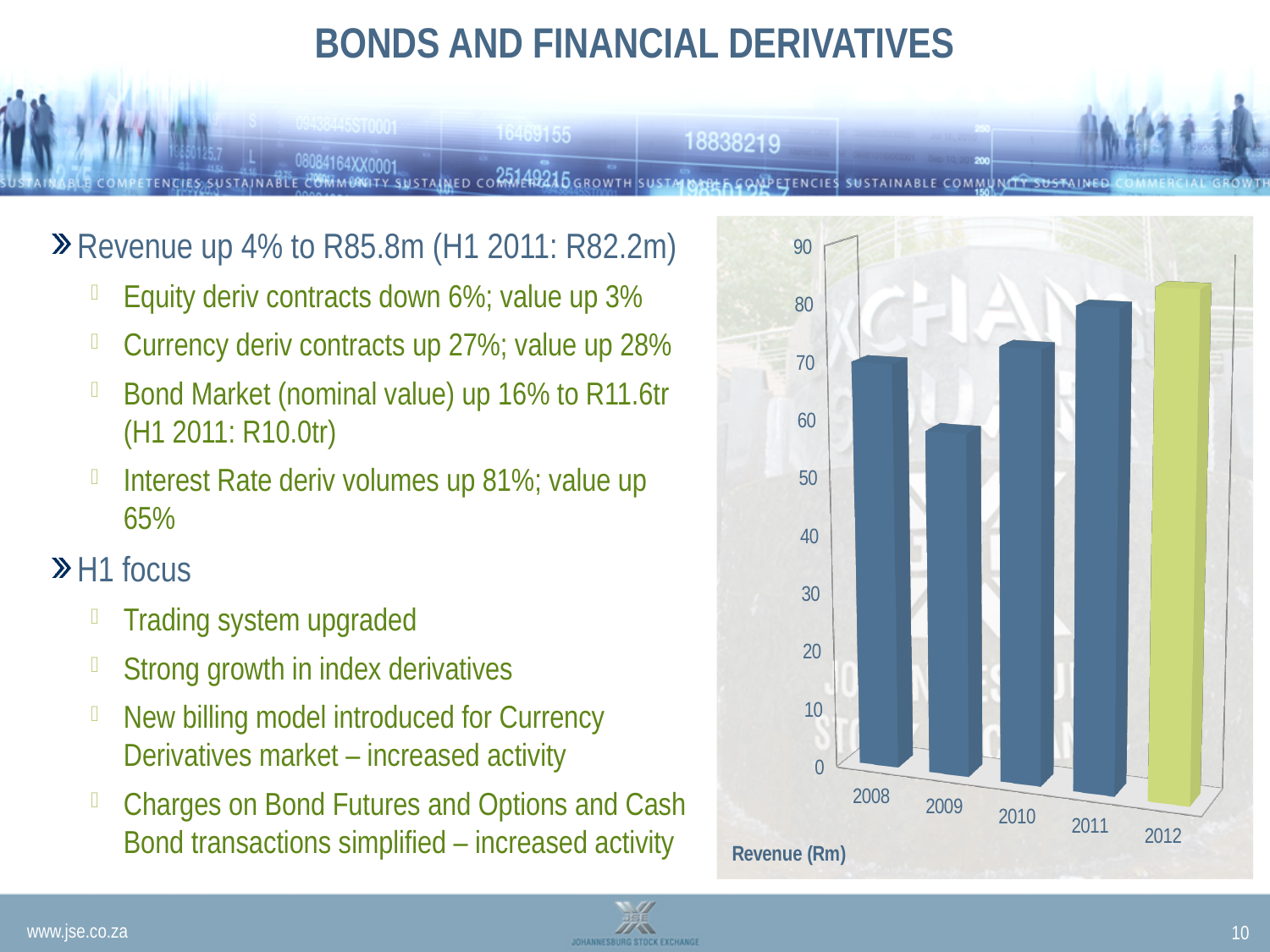
Do the revenue bars rise or fall from 2009 to 2012? rise How many years are plotted on the chart? 5 What label is shown beneath the chart describing the plotted values? Revenue (Rm) Is the revenue value for 2009 greater or less than 50? greater What kind of chart is shown on the slide? bar chart Which year has the larger revenue bar, 2009 or 2010? 2010 Is the revenue value for 2008 greater or less than 60? greater Which year has the lowest revenue bar? 2009 Is the revenue value for 2012 greater or less than 80? greater Which year has the highest revenue bar? 2012 Which year has the larger revenue bar, 2008 or 2011? 2011